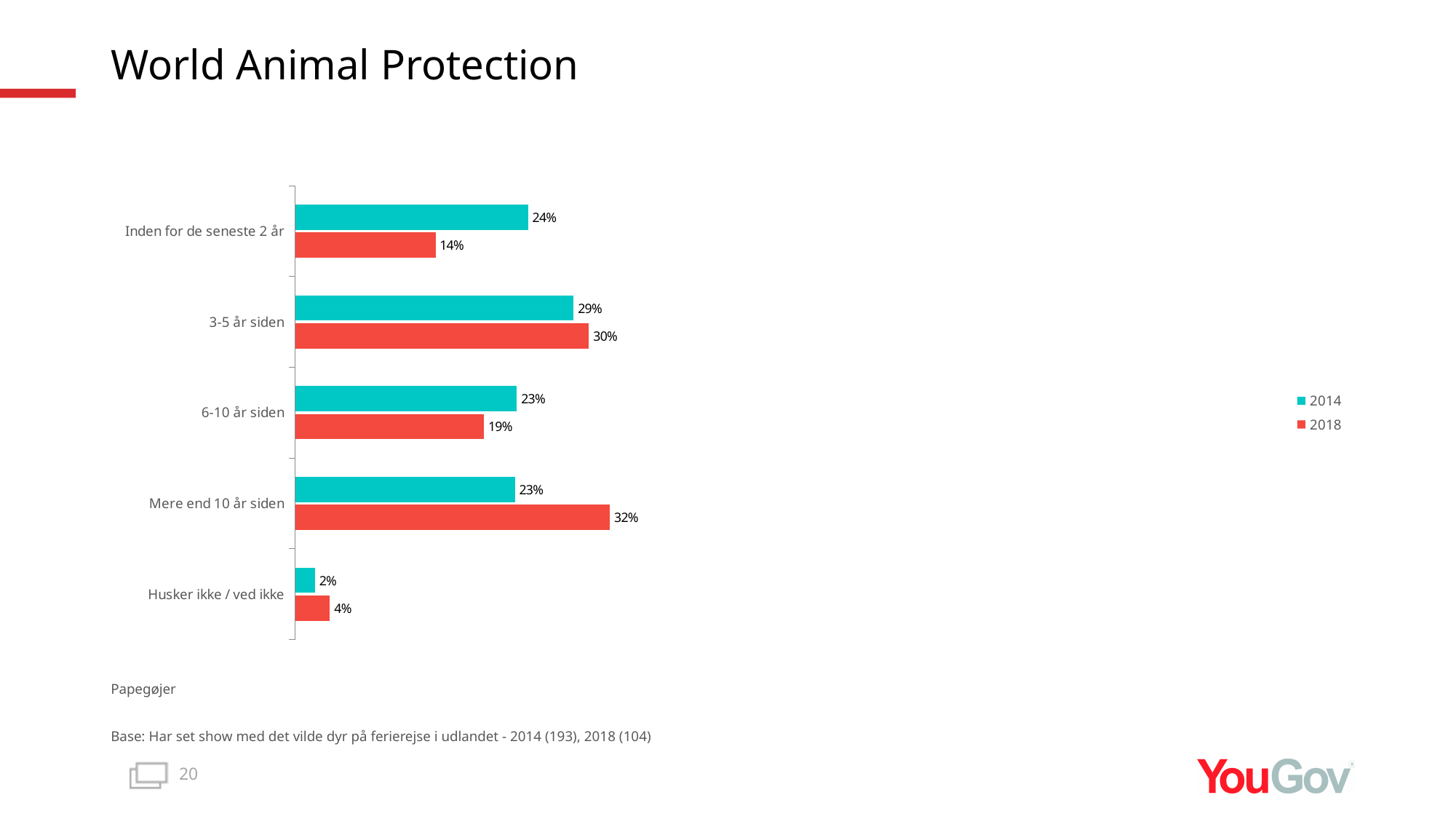
Which category has the lowest 2014 value? Husker ikke / ved ikke How many categories are shown on the chart? 5 What is the difference between the 2014 and 2018 values for "Inden for de seneste 2 år"? 10% How many series does the legend list? 2 Which category has the highest 2018 value? Mere end 10 år siden What is the 2018 value for "6-10 år siden"? 19% What is the 2014 value for "Inden for de seneste 2 år"? 24% What is the difference between the 2018 and 2014 values for "Mere end 10 år siden"? 9% For "6-10 år siden", which series has the larger value, 2014 or 2018? 2014 What kind of chart is shown on the slide? Bar chart What is the 2018 value for "Mere end 10 år siden"? 32% For "Husker ikke / ved ikke", which series has the larger value, 2014 or 2018? 2018